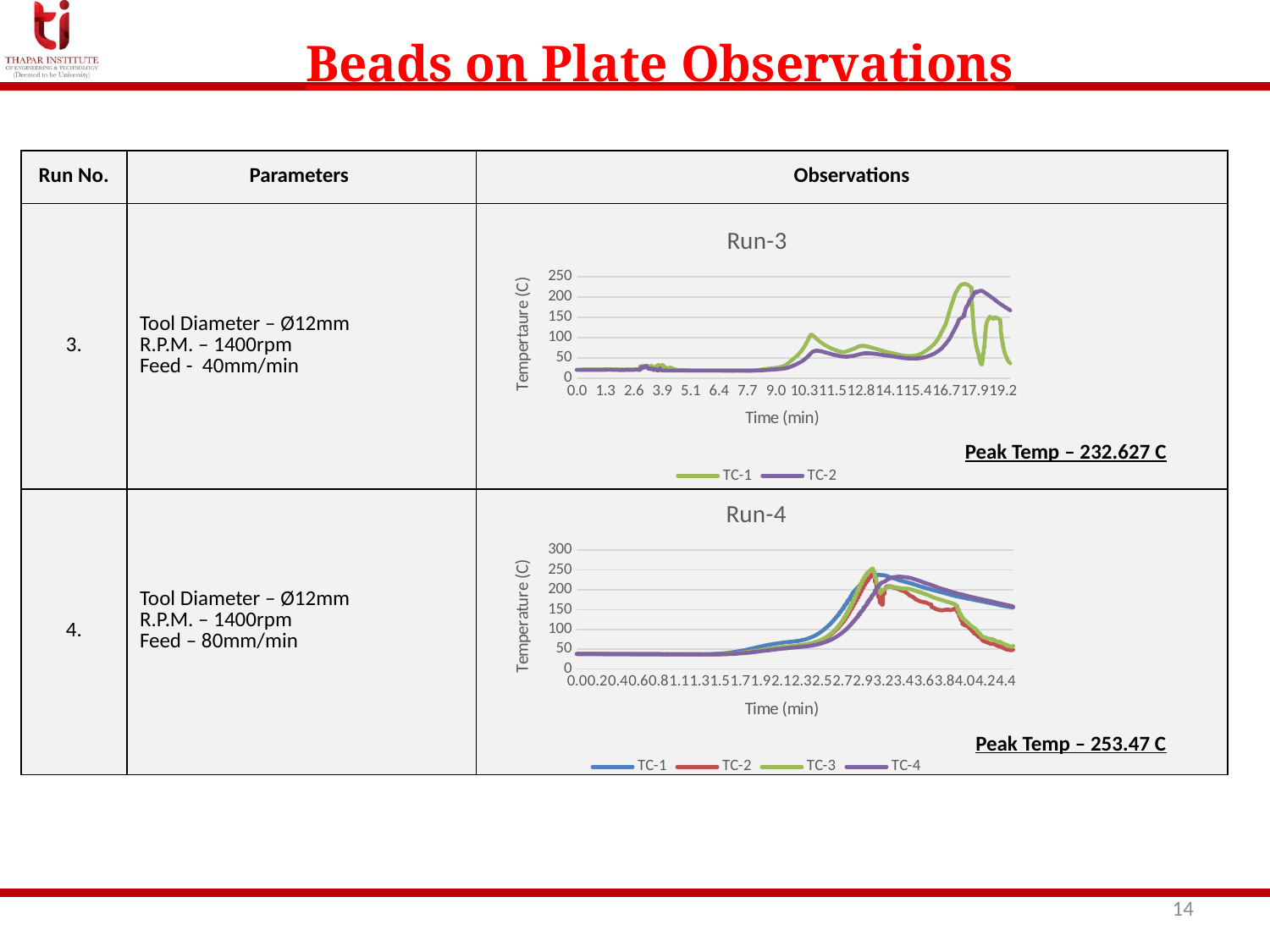
What kind of chart is the Run-3 chart? line chart What is the highest tick value shown on the y-axis of the Run-4 chart? 300 In the Run-3 chart, does the TC-2 series end higher or lower than it starts? higher In the Run-3 chart, which series reaches the higher peak, TC-1 or TC-2? TC-1 In the Run-4 chart, is the value of TC-4 at time 0.0 greater or less than 100? less In the Run-4 chart, is the peak value of TC-1 greater or less than 200? greater In the Run-4 chart, is the final value of TC-2 at time 4.4 greater or less than 100? less What is the x-axis title of the Run-4 chart? Time (min) How many series does the legend of the Run-3 chart list? 2 How many series does the legend of the Run-4 chart list? 4